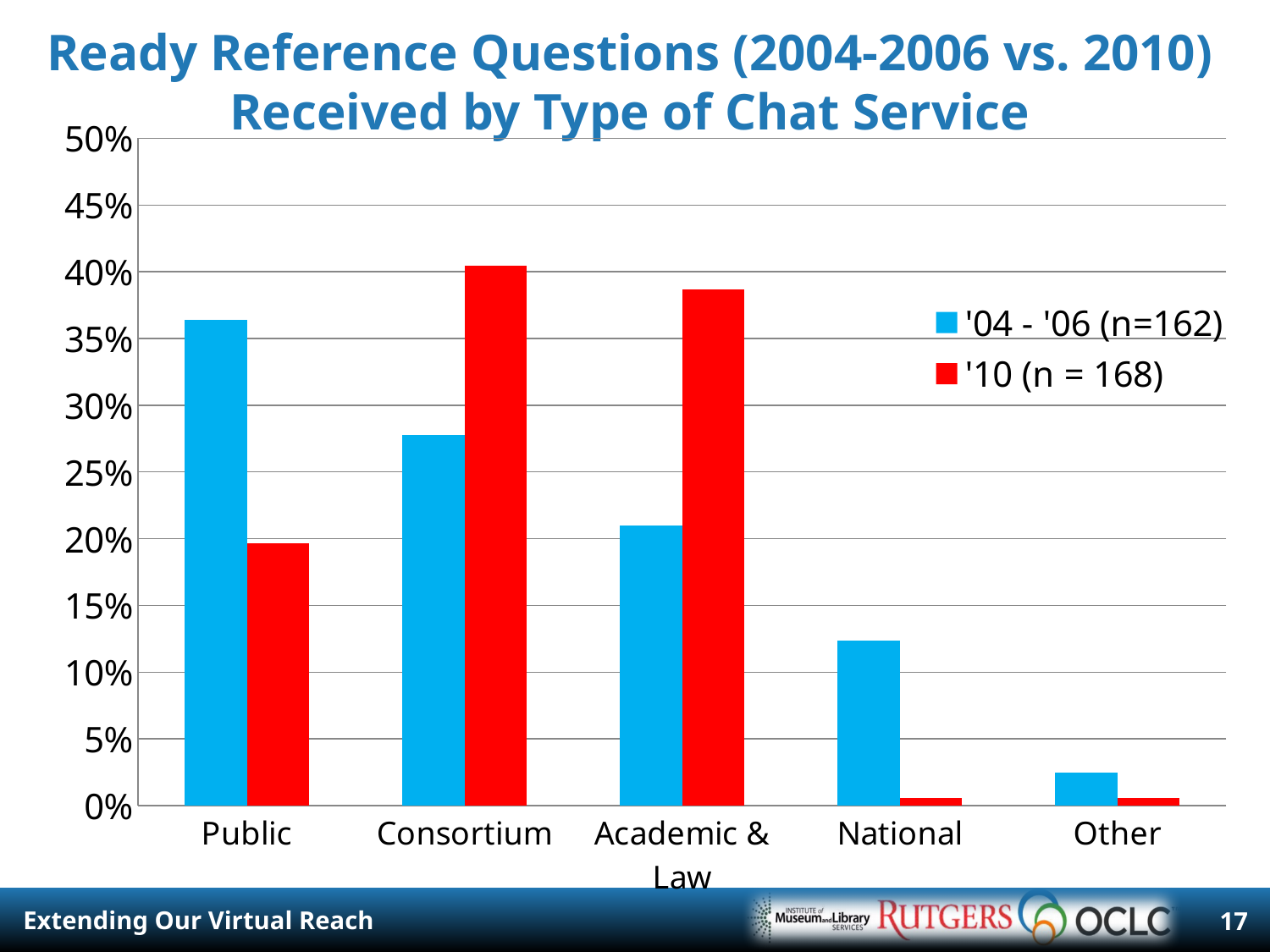
Is the '04 - '06 (n=162) value for Public greater or less than 35%? greater Is the '04 - '06 (n=162) value for National greater or less than 10%? greater Which type of chat service has the highest value for the '04 - '06 (n=162) series? Public Which type of chat service has the lowest value for the '04 - '06 (n=162) series? Other For Academic & Law, which series has the larger value, '04 - '06 (n=162) or '10 (n = 168)? '10 (n = 168) How many series does the legend list? 2 What kind of chart is shown on the slide? Bar chart Which type of chat service has the highest value for the '10 (n = 168) series? Consortium Which colour represents the '10 (n = 168) series? Red How many types of chat service are shown on the x axis? 5